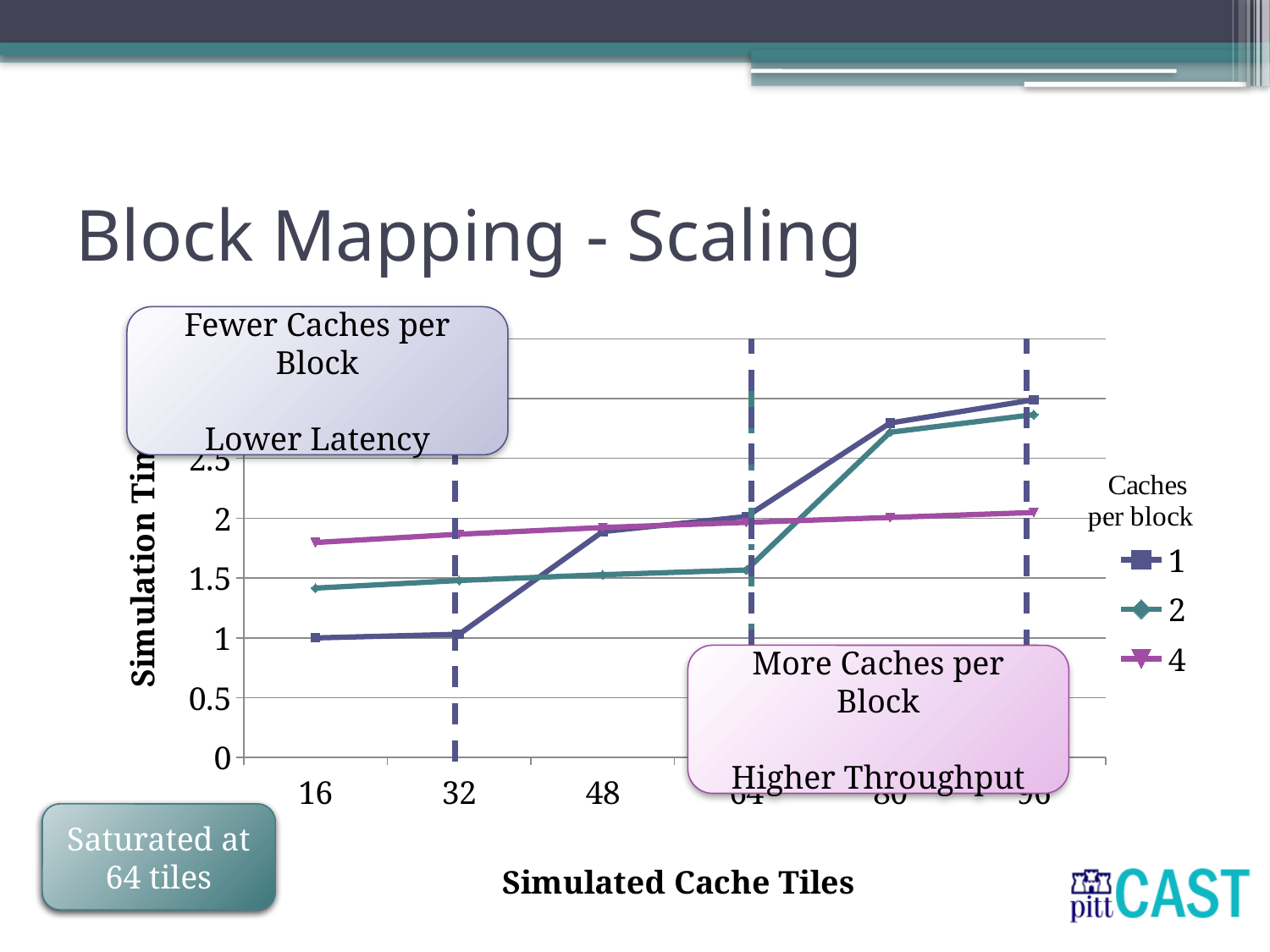
What kind of chart is shown on the slide? line chart Is the simulation time for 1 cache per block at 16 tiles greater or less than 1.5? less Does the simulation time for 1 cache per block rise or fall as the number of simulated cache tiles increases? rise What is the title of the x axis? Simulated Cache Tiles Is the simulation time for 4 caches per block at 16 tiles greater or less than 1.5? greater What is the title of the legend? Caches per block At 16 tiles, which series has the highest simulation time? 4 How many points are shown along the x axis (Simulated Cache Tiles)? 6 At 96 tiles, which series has the lowest simulation time? 4 How many series does the legend list? 3 Is the simulation time for 2 caches per block at 64 tiles greater or less than 2? less